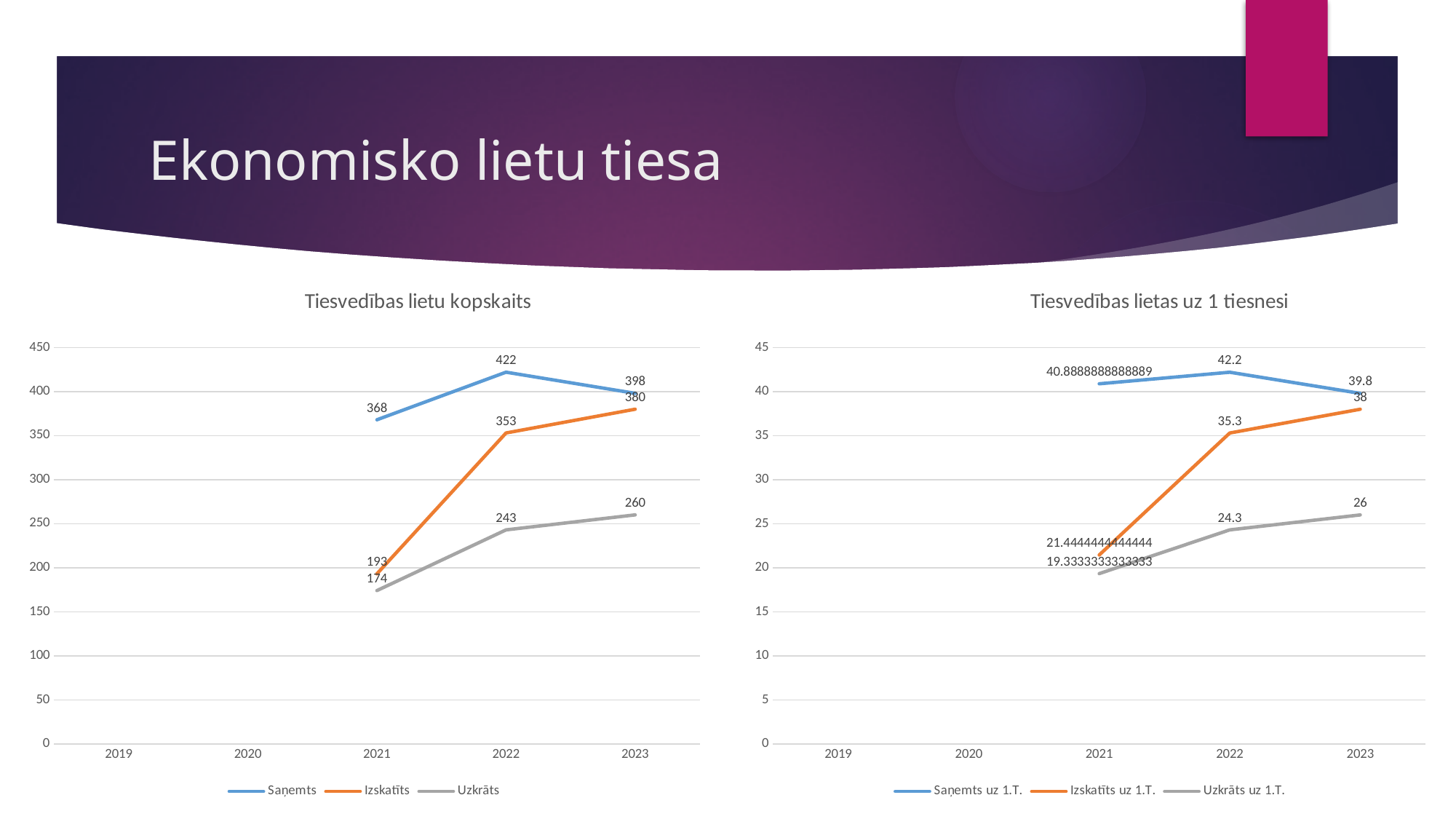
In the chart 'Tiesvedības lietas uz 1 tiesnesi', what is the value of Uzkrāts uz 1.T. in 2022? 24.3 How many series does the legend of the chart 'Tiesvedības lietas uz 1 tiesnesi' list? 3 In the chart 'Tiesvedības lietas uz 1 tiesnesi', what is the value of Saņemts uz 1.T. in 2022? 42.2 What kind of chart is 'Tiesvedības lietu kopskaits'? line chart In the chart 'Tiesvedības lietu kopskaits', does Uzkrāts rise or fall from 2021 to 2023? rise In the chart 'Tiesvedības lietu kopskaits', what is the difference between Izskatīts in 2022 and Izskatīts in 2021? 160 In the chart 'Tiesvedības lietas uz 1 tiesnesi', what is the value of Izskatīts uz 1.T. in 2023? 38 In the chart 'Tiesvedības lietu kopskaits', what is the value of Izskatīts in 2021? 193 In the chart 'Tiesvedības lietu kopskaits', what is the value of Uzkrāts in 2023? 260 In the chart 'Tiesvedības lietu kopskaits', which is larger in 2023: Saņemts or Izskatīts? Saņemts In the chart 'Tiesvedības lietu kopskaits', in which year is Saņemts highest? 2022 In the chart 'Tiesvedības lietu kopskaits', what is the value of Saņemts in 2022? 422